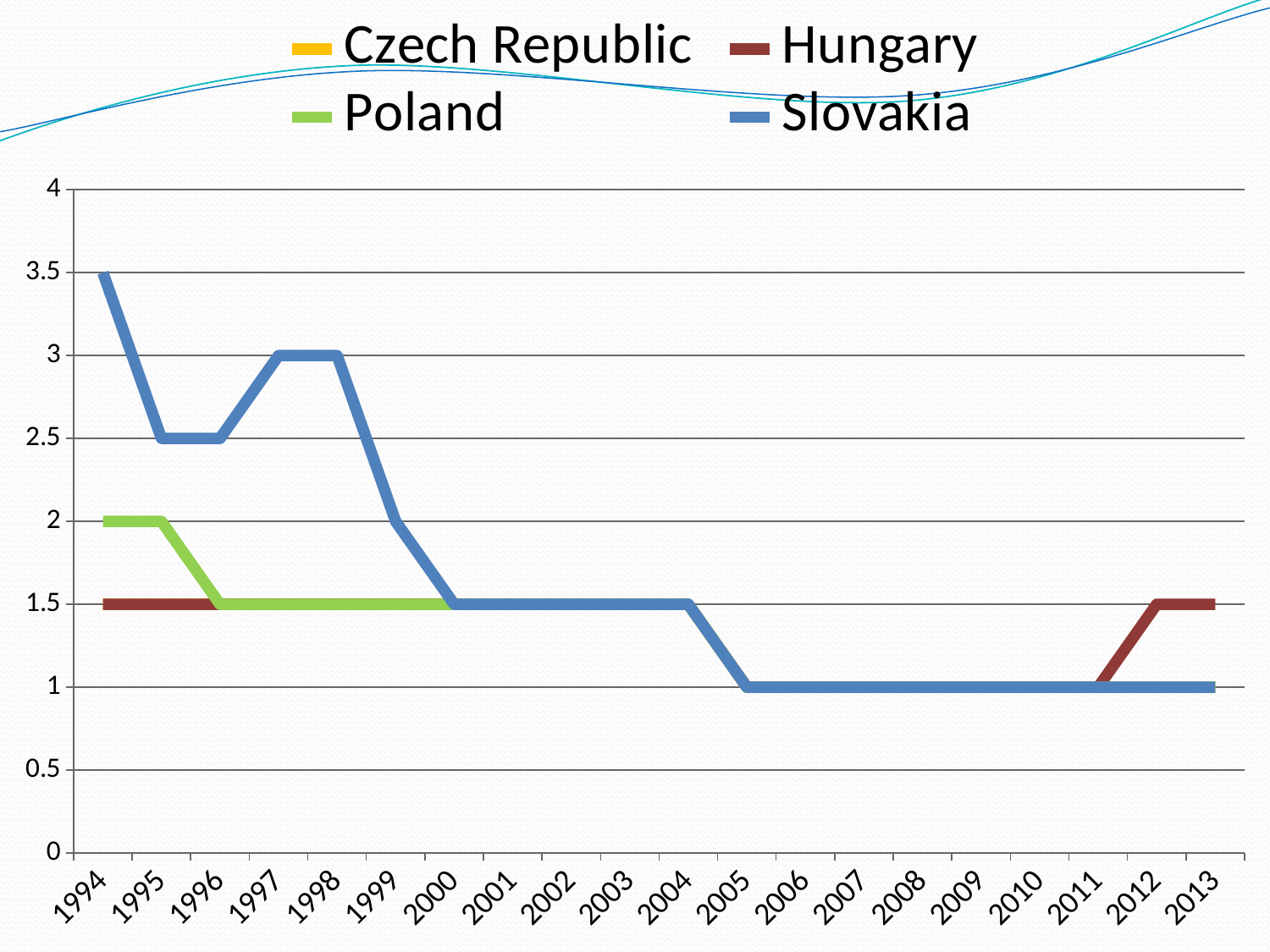
How many series does the legend list? 4 In which year is the value for Slovakia highest? 1994 What kind of chart is shown on the slide? line chart What is the value for Poland in 1994? 2 Which is larger for Slovakia, the value in 1994 or the value in 1997? 1994 What is the value for Slovakia in 2013? 1 What is the value for Slovakia in 1997? 3 What is the difference between the Slovakia value in 1994 and in 2013? 2.5 Does the Slovakia line overall rise or fall from 1994 to 2013? fall What is the value for Slovakia in 1994? 3.5 How many years are shown along the x axis? 20 What is the value for Hungary in 2012? 1.5